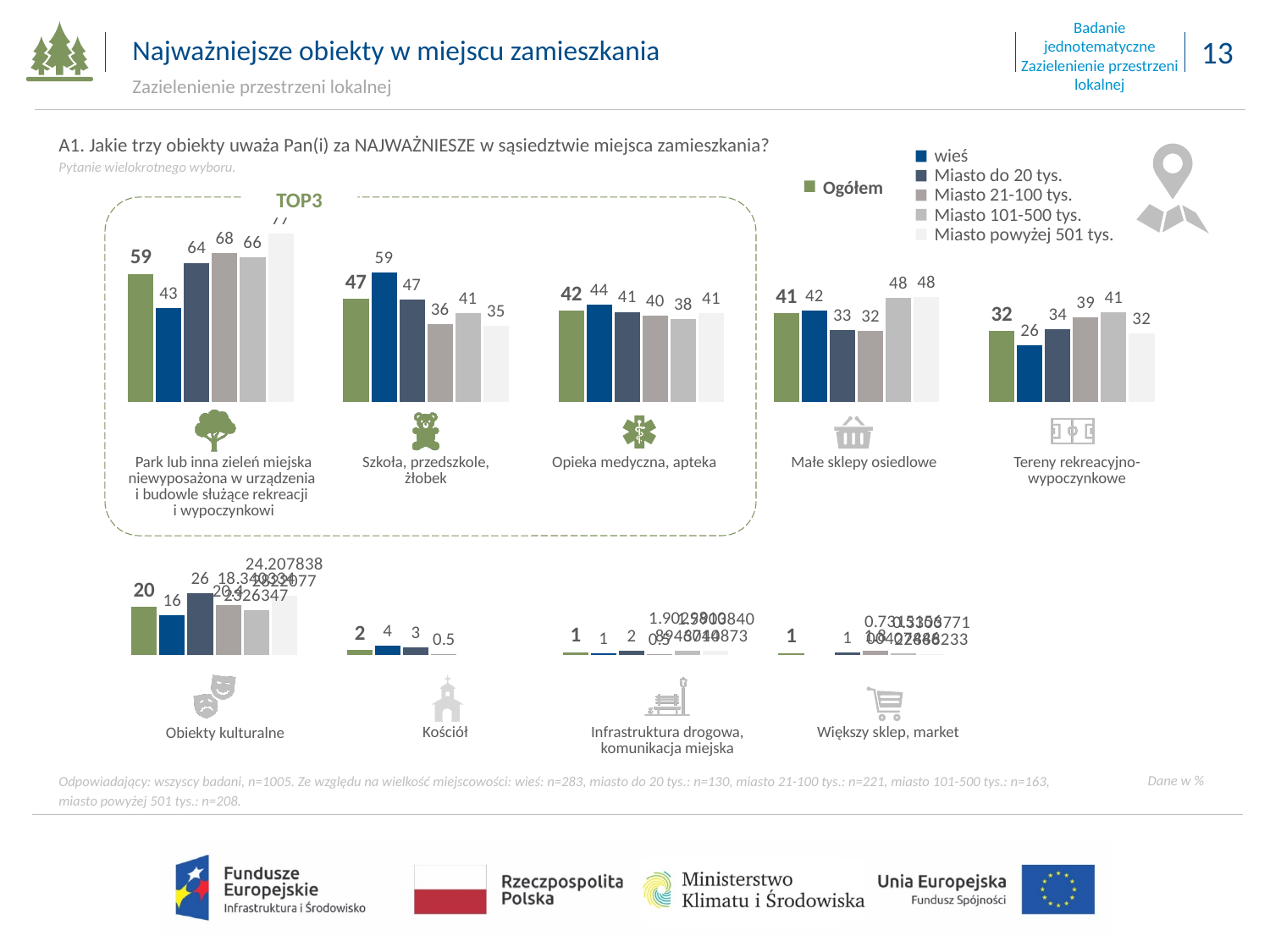
In the 'Małe sklepy osiedlowe' chart, what is the value for Miasto 101-500 tys.? 48 In the 'Tereny rekreacyjno-wypoczynkowe' chart, what is the value for Miasto 101-500 tys.? 41 In the 'Tereny rekreacyjno-wypoczynkowe' chart, which group has the lowest value? wieś In the 'Szkoła, przedszkole, żłobek' chart, which group has the highest value? wieś In the 'Małe sklepy osiedlowe' chart, what is the difference between the value for wieś and the value for Miasto 21-100 tys.? 10 In the 'Obiekty kulturalne' chart, what is the value for Miasto do 20 tys.? 26 What type of chart is used for 'Opieka medyczna, apteka'? Bar chart In the 'Kościół' chart, what is the Ogółem value? 2 How many series does the legend list? 6 In the 'Park lub inna zieleń miejska...' chart, what is the Ogółem value? 59 In the 'Szkoła, przedszkole, żłobek' chart, what is the value for wieś? 59 In the 'Opieka medyczna, apteka' chart, which is larger: the value for wieś or the value for Miasto 101-500 tys.? wieś